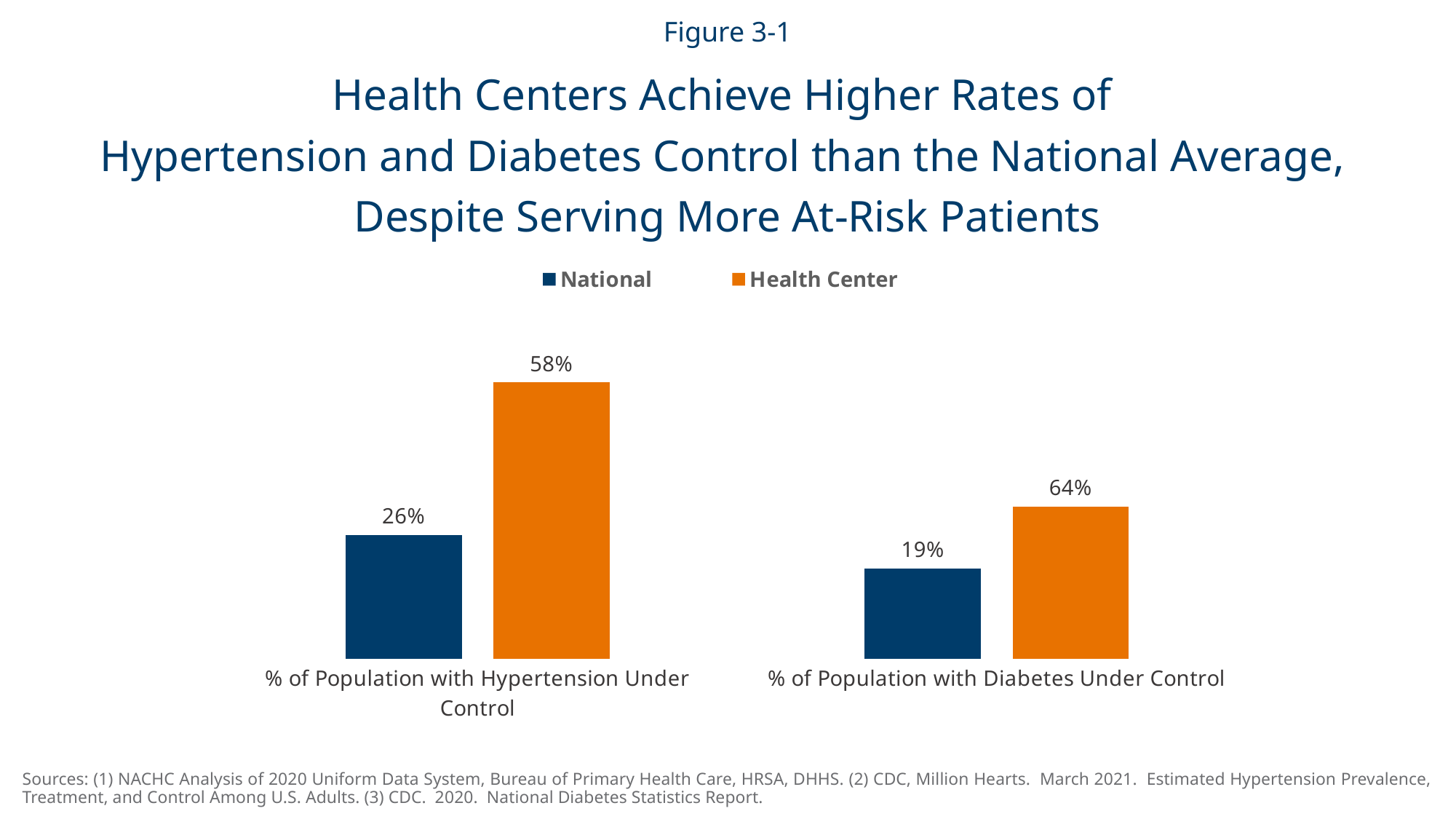
What is the National value for % of Population with Diabetes Under Control? 19% How many series does the legend list? 2 Which bar has the lowest value on the chart? National, % of Population with Diabetes Under Control What is the difference between the Health Center and National values for % of Population with Diabetes Under Control? 45% Which is larger for % of Population with Diabetes Under Control: the National value or the Health Center value? Health Center What is the National value for % of Population with Hypertension Under Control? 26% What is the difference between the Health Center and National values for % of Population with Hypertension Under Control? 32% How many categories are shown on the x axis? 2 What is the Health Center value for % of Population with Hypertension Under Control? 58% What kind of chart is shown on the slide? Bar chart What is the Health Center value for % of Population with Diabetes Under Control? 64%